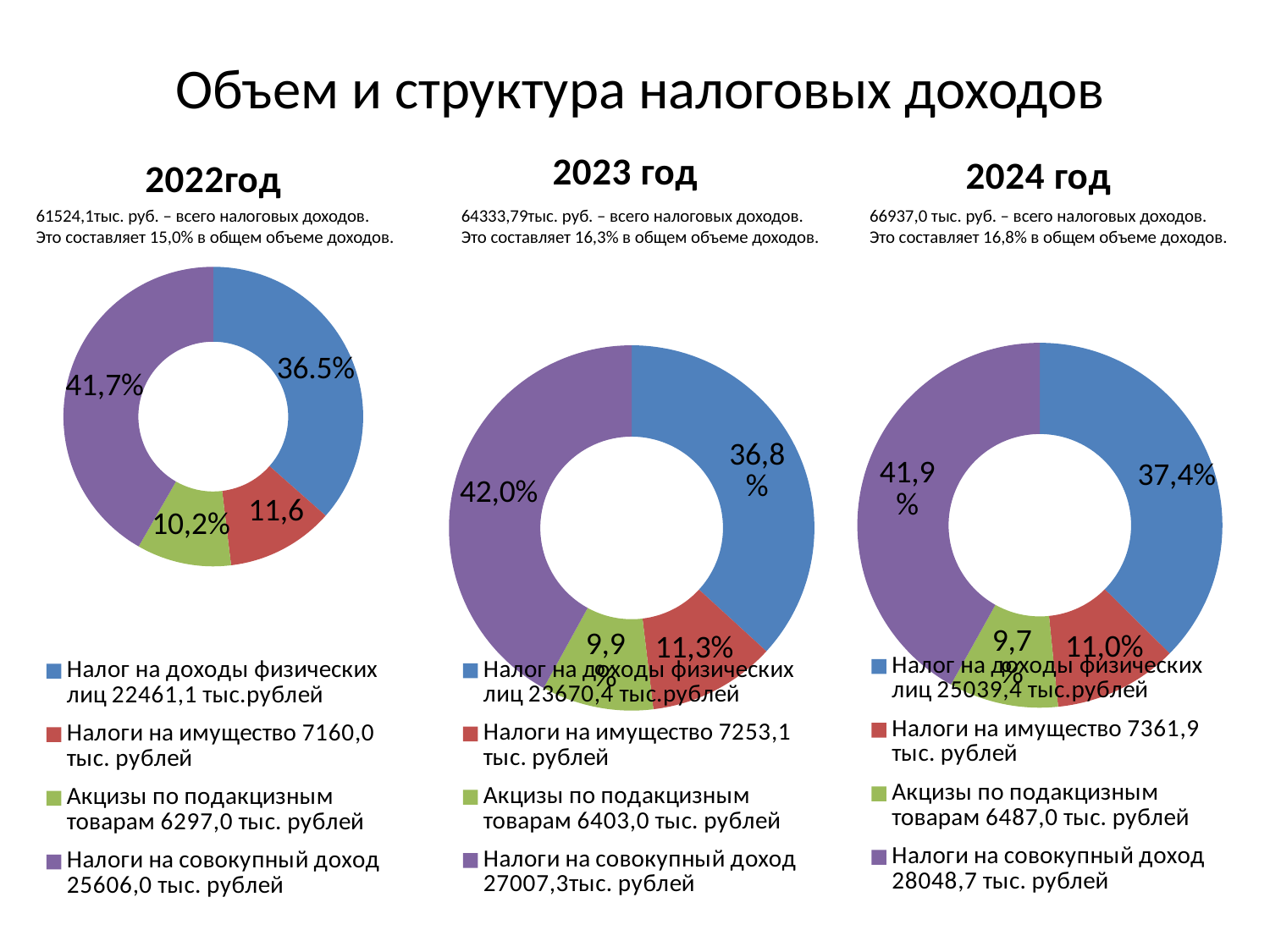
In the 2024 год chart, what is the difference between the share of Налоги на совокупный доход and the share of Налог на доходы физических лиц? 4,5% In the 2024 год chart, which category has the largest share? Налоги на совокупный доход In the 2023 год chart, what share does Акцизы по подакцизным товарам have? 9,9% In the 2023 год chart, what share does Налоги на имущество have? 11,3% In the 2022 год chart, what share does Налоги на совокупный доход have? 41,7% In the 2022 год chart, which is larger: the share of Налоги на имущество or the share of Акцизы по подакцизным товарам? Налоги на имущество In the 2023 год chart, which category has the smallest share? Акцизы по подакцизным товарам What kind of chart is used for the 2022 год chart? doughnut chart How many categories does the 2024 год chart show? 4 According to the legend of the 2023 год chart, what amount is given for Налоги на совокупный доход? 27007,3тыс. рублей